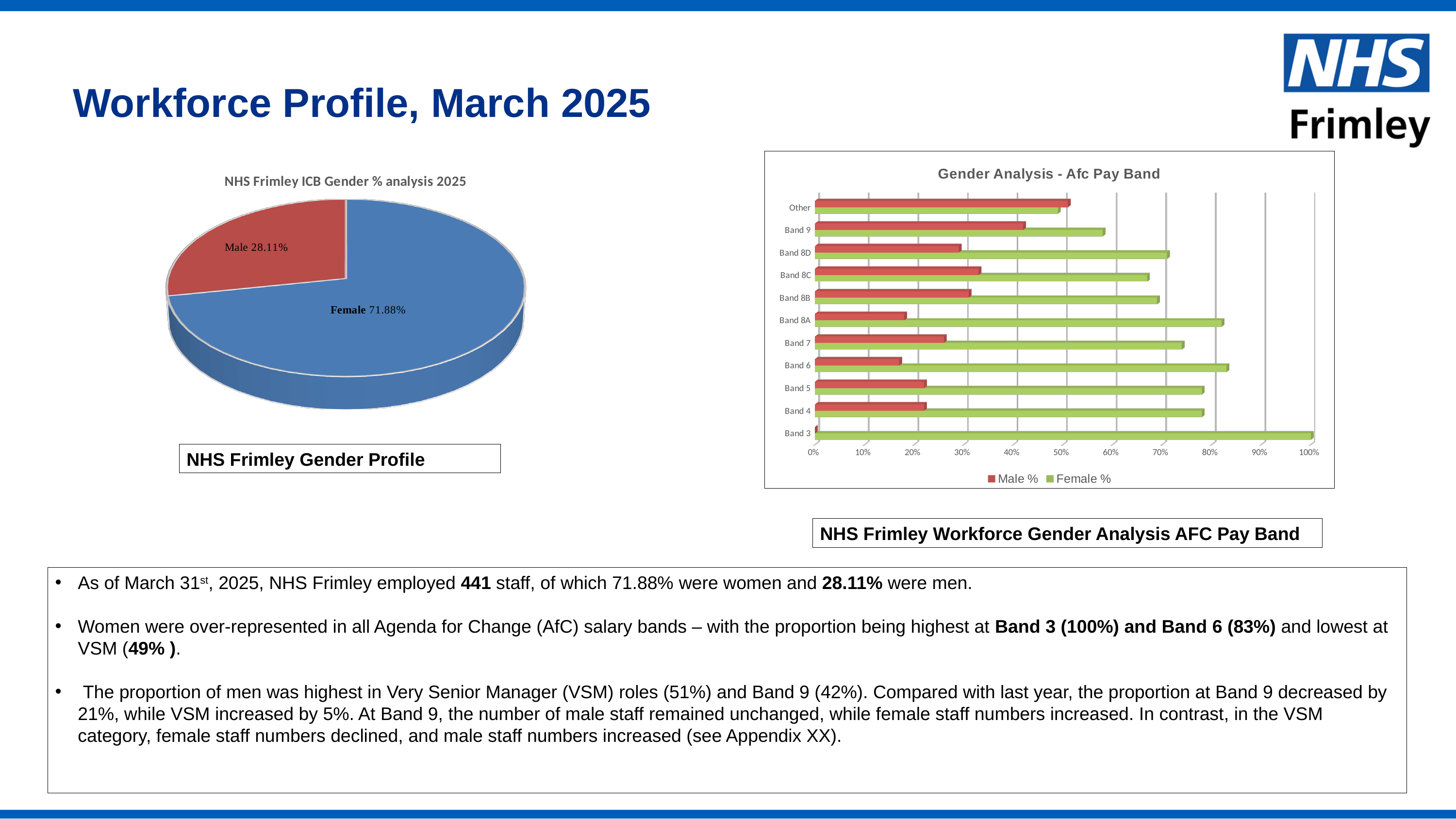
In the pie chart titled 'NHS Frimley ICB Gender % analysis 2025', what percentage is shown for Male? 28.11% In the pie chart titled 'NHS Frimley ICB Gender % analysis 2025', what percentage is shown for Female? 71.88% In the 'Gender Analysis - Afc Pay Band' chart, is the Male % value for Band 8A greater or less than 20%? less How many pay band categories are shown on the 'Gender Analysis - Afc Pay Band' chart? 11 How many series does the legend of the 'Gender Analysis - Afc Pay Band' chart list? 2 In the 'Gender Analysis - Afc Pay Band' chart, which category has the highest Female %? Band 3 In the 'Gender Analysis - Afc Pay Band' chart, which has the larger Male % value, Band 9 or Band 8D? Band 9 What kind of chart is the 'NHS Frimley ICB Gender % analysis 2025' chart on the left of the slide? Pie chart In the pie chart on the left, which slice is larger, Male or Female? Female In the 'Gender Analysis - Afc Pay Band' chart, is the Female % value for Band 3 greater or less than 90%? greater In the 'Gender Analysis - Afc Pay Band' chart, which category has the highest Male %? Other What kind of chart is the 'Gender Analysis - Afc Pay Band' chart on the right of the slide? Bar chart